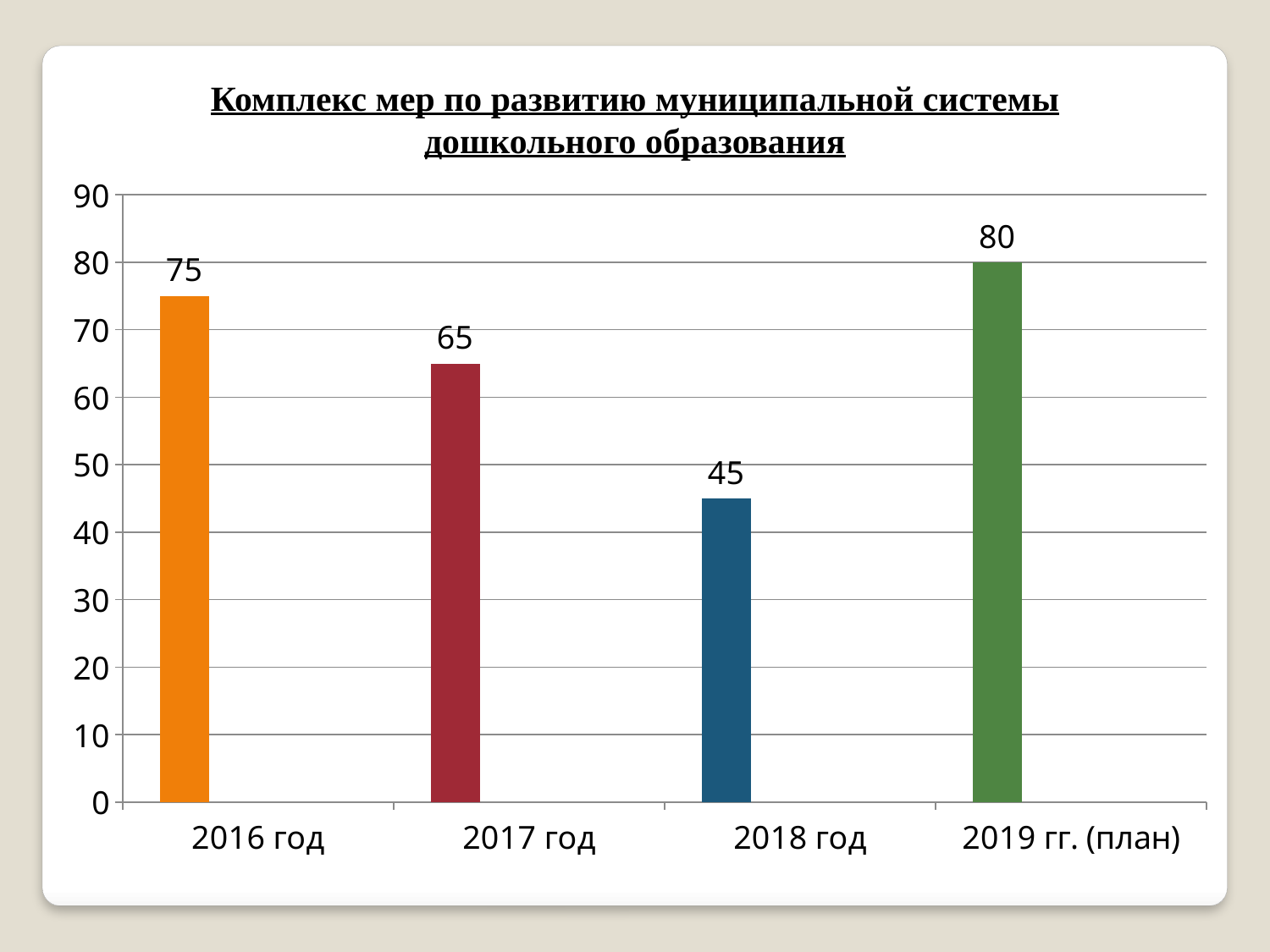
What kind of chart is shown on the slide? bar chart What is the difference between the values for 2016 год and 2018 год? 30 What is the value for 2018 год? 45 Is the value for 2018 год greater or less than 50? less What is the value for 2016 год? 75 Which category has the lowest value? 2018 год What is the title of the chart? Комплекс мер по развитию муниципальной системы дошкольного образования What is the value for 2019 гг. (план)? 80 Which is larger, the value for 2017 год or the value for 2019 гг. (план)? 2019 гг. (план) Which category has the highest value? 2019 гг. (план) What is the value for 2017 год? 65 How many categories are shown on the x axis? 4